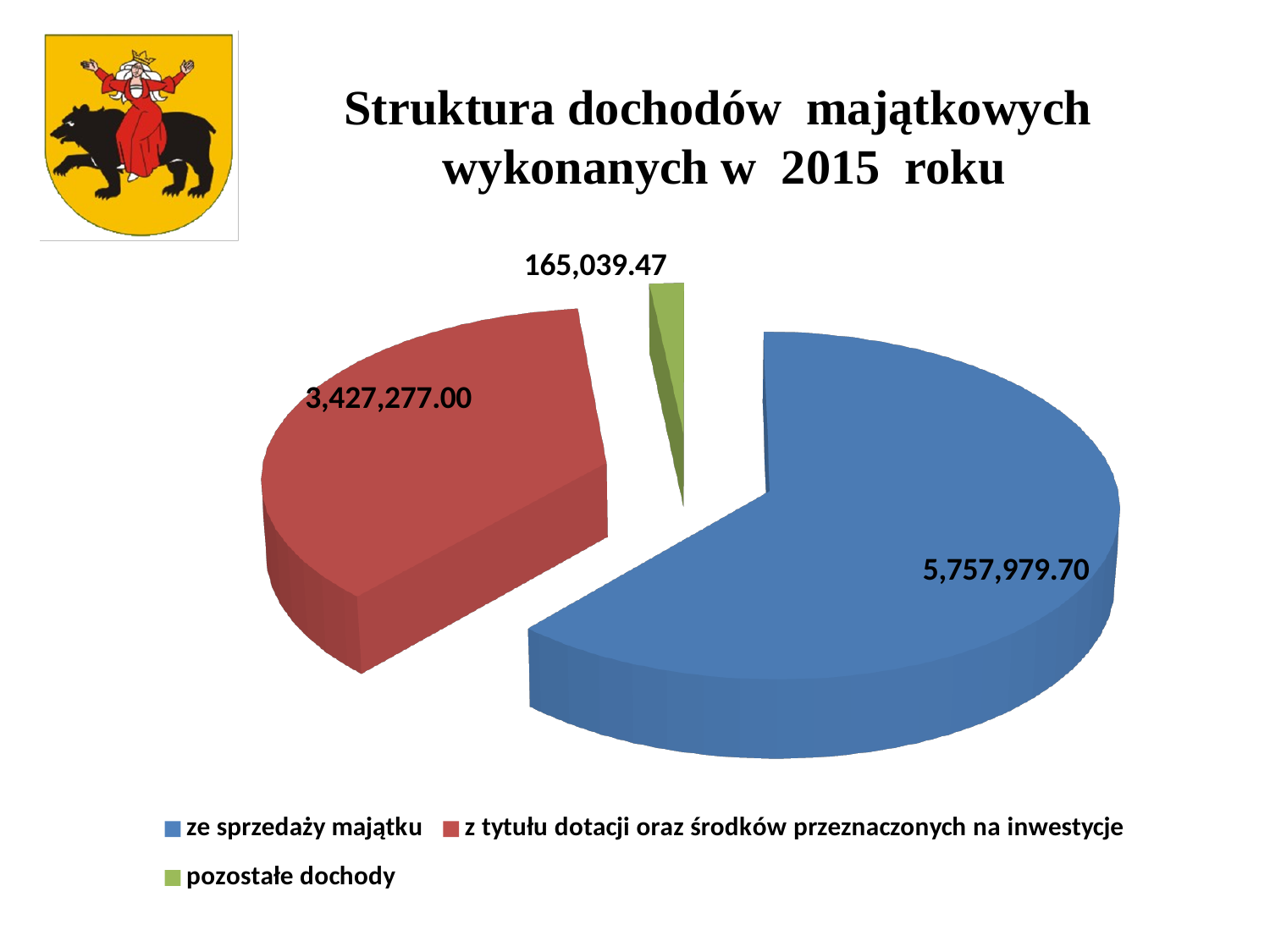
Which category has the smallest value? pozostałe dochody How many slices does the pie chart have? 3 Which is larger: "z tytułu dotacji oraz środków przeznaczonych na inwestycje" or "pozostałe dochody"? z tytułu dotacji oraz środków przeznaczonych na inwestycje What type of chart is shown on the slide? Pie chart What is the total of all slices in the pie chart? 9,350,296.17 What is the value for "ze sprzedaży majątku"? 5,757,979.70 What colour is the slice for "pozostałe dochody"? Green What is the difference between the value for "ze sprzedaży majątku" and the value for "z tytułu dotacji oraz środków przeznaczonych na inwestycje"? 2,330,702.70 What is the value for "pozostałe dochody"? 165,039.47 What is the value for "z tytułu dotacji oraz środków przeznaczonych na inwestycje"? 3,427,277.00 Which category has the largest value? ze sprzedaży majątku